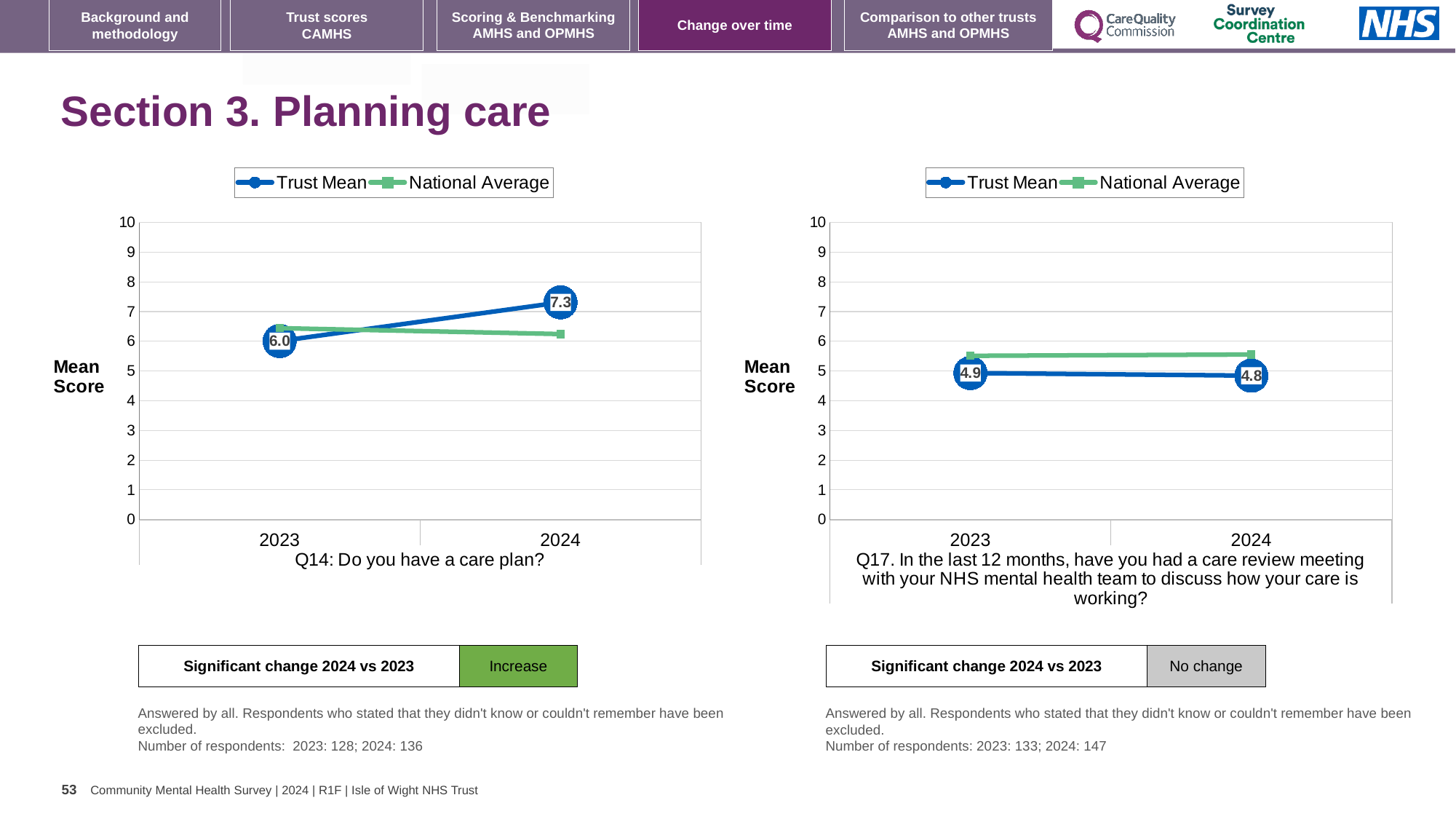
How many series does the legend of the right chart (Q17) list? 2 What kind of chart is the left chart (Q14)? line chart In the left chart (Q14), by how much did the Trust Mean score change from 2023 to 2024? 1.3 In the right chart (Q17), which series is higher in 2024, Trust Mean or National Average? National Average In the right chart (Q17, care review meeting), what is the Trust Mean score for 2023? 4.9 In the left chart (Q14: Do you have a care plan?), what is the Trust Mean score for 2023? 6.0 In the left chart (Q14), does the Trust Mean rise or fall from 2023 to 2024? rise In the left chart (Q14: Do you have a care plan?), what is the Trust Mean score for 2024? 7.3 In the right chart (Q17), does the Trust Mean rise or fall from 2023 to 2024? fall In the right chart (Q17, care review meeting), what is the Trust Mean score for 2024? 4.8 In the right chart (Q17), is the National Average value for 2024 greater or less than 5? greater How many years are shown on the x axis of the left chart (Q14)? 2